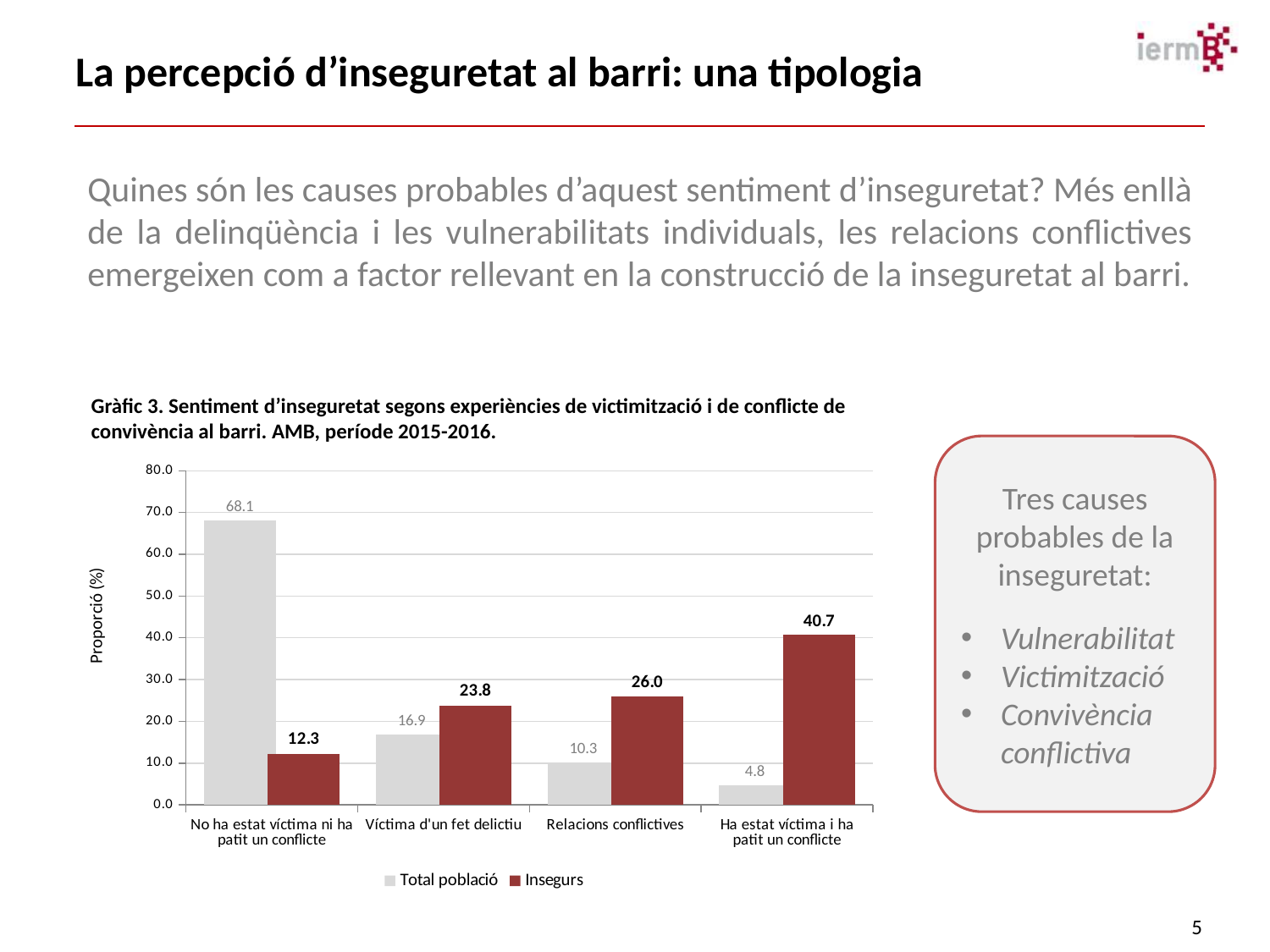
What is the label of the y axis of the chart? Proporció (%) Which category has the highest value for the 'Insegurs' series? Ha estat víctima i ha patit un conflicte Which category has the lowest value for the 'Total població' series? Ha estat víctima i ha patit un conflicte What is the value for 'Total població' in the 'No ha estat víctima ni ha patit un conflicte' category? 68.1 What is the value for 'Insegurs' in the 'Relacions conflictives' category? 26.0 Which is larger in the 'Víctima d'un fet delictiu' category: 'Total població' or 'Insegurs'? Insegurs How many series does the chart legend list? 2 What is the value for 'Insegurs' in the 'Ha estat víctima i ha patit un conflicte' category? 40.7 What is the value for 'Total població' in the 'Víctima d'un fet delictiu' category? 16.9 How many categories are shown on the x axis of the chart? 4 What is the difference between 'Insegurs' and 'Total població' in the 'Relacions conflictives' category? 15.7 What kind of chart is shown on the slide? Bar chart